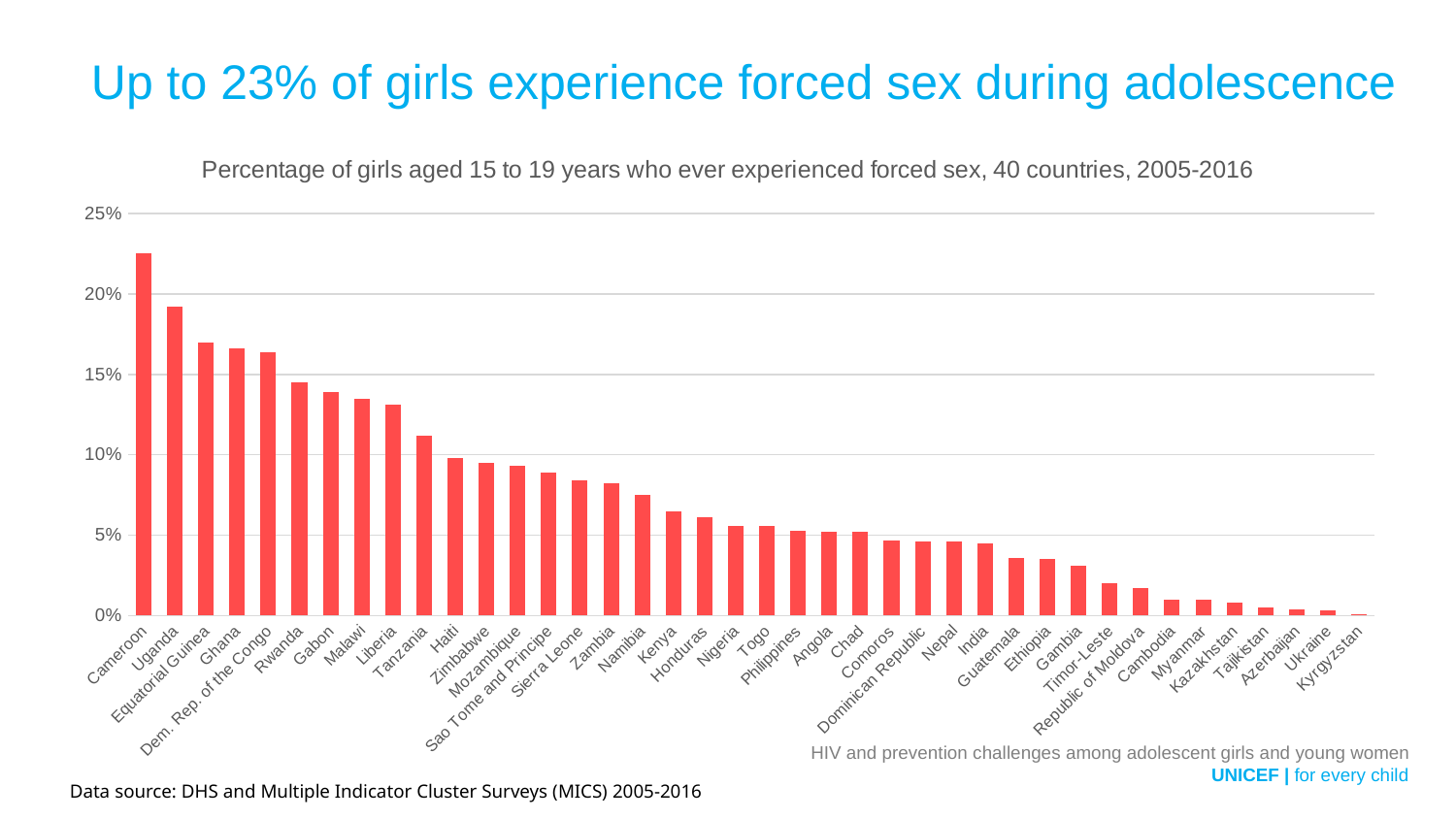
Is the value for Uganda greater or less than 20%? less What kind of chart is shown on the slide? bar chart Do the values rise or fall moving from left to right along the x axis? fall Which has a higher value, Uganda or Ghana? Uganda Is the value for Tanzania greater or less than 10%? greater How many countries are shown in the chart? 40 Which country has the highest percentage of girls aged 15 to 19 who ever experienced forced sex? Cameroon What is the title of the chart? Percentage of girls aged 15 to 19 years who ever experienced forced sex, 40 countries, 2005-2016 Is the value for Cameroon greater or less than 20%? greater Which country has the lowest percentage in the chart? Kyrgyzstan